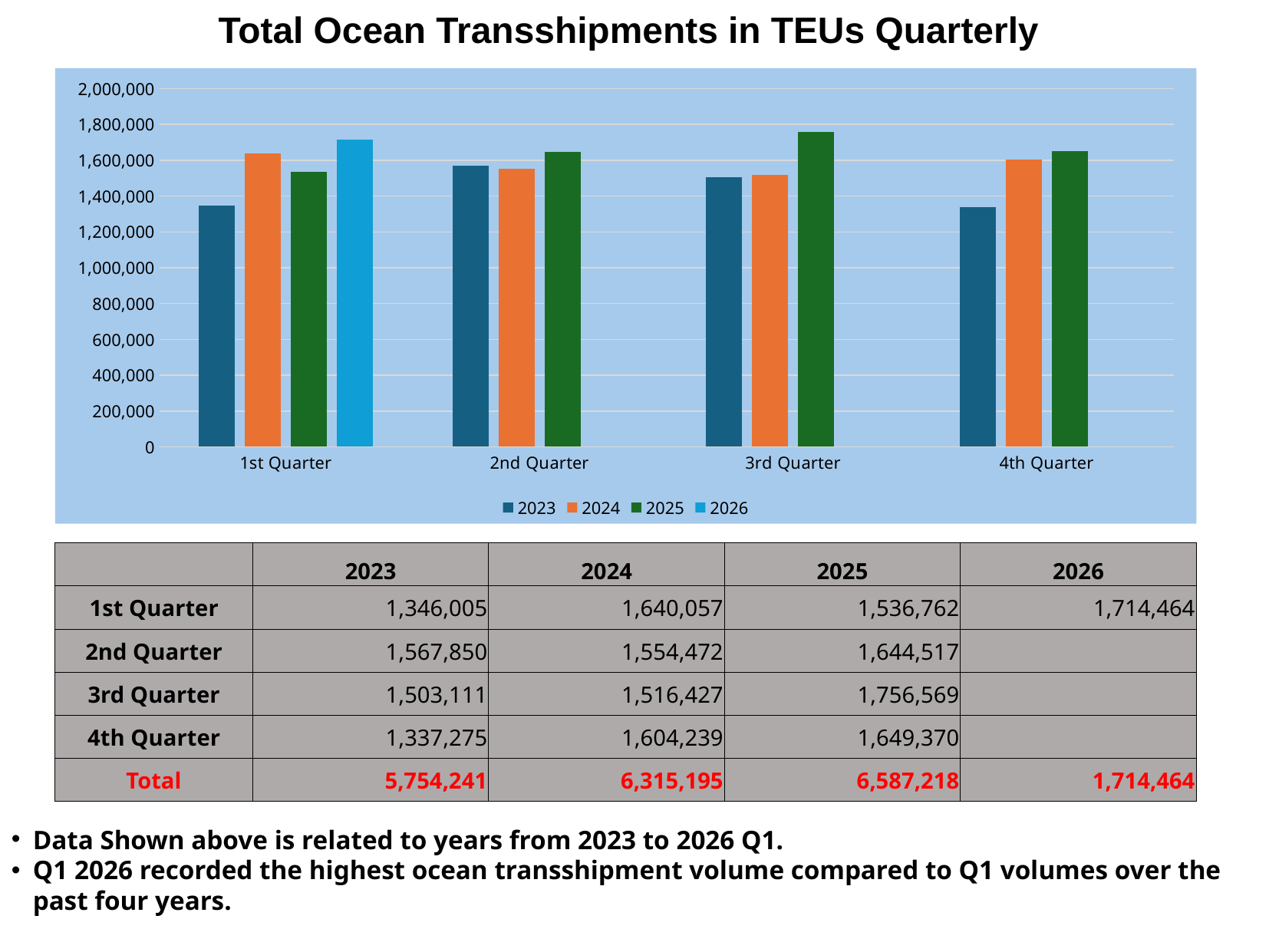
How many quarter categories are shown on the x axis? 4 Is the value for 2023 in the 4th Quarter greater or less than 1,400,000? less What is the value for 2023 in the 4th Quarter? 1,337,275 Which year has the highest value in the 3rd Quarter? 2025 How many series does the legend list? 4 What is the difference between the 2024 and 2023 values in the 1st Quarter? 294,052 What kind of chart is shown on the slide? bar chart In the 2nd Quarter, which is larger: the value for 2023 or the value for 2024? 2023 What is the total for 2025 across all four quarters? 6,587,218 What is the value for 2025 in the 3rd Quarter? 1,756,569 What is the value for 2026 in the 1st Quarter? 1,714,464 Which year has the lowest value in the 4th Quarter? 2023